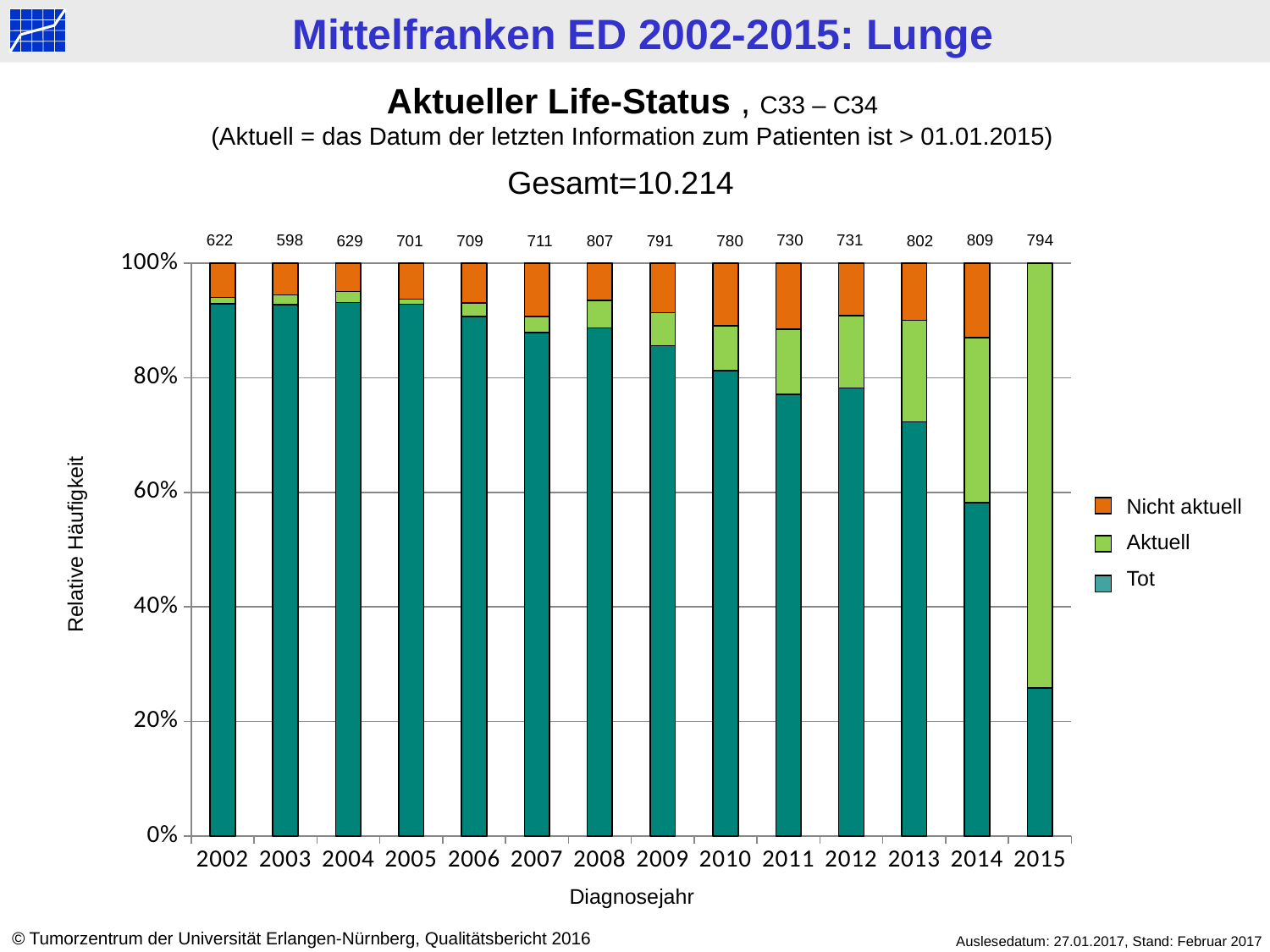
Which diagnosis year has the lowest number printed above its bar? 2003 What is the number printed above the bar for 2015? 794 Does the 'Tot' share rise or fall from 2002 to 2015? Fall How many series does the legend list? 3 How many diagnosis years are shown on the x axis? 14 What kind of chart is shown on the slide? Stacked bar chart What is the difference between the numbers printed above the bars for 2014 and 2003? 211 Which diagnosis year has the highest number printed above its bar? 2014 Which year has the larger number printed above its bar, 2010 or 2011? 2010 Is the 'Tot' share for 2002 greater or less than 80%? greater Is the 'Tot' share for 2015 greater or less than 40%? less What is the number printed above the bar for 2002? 622